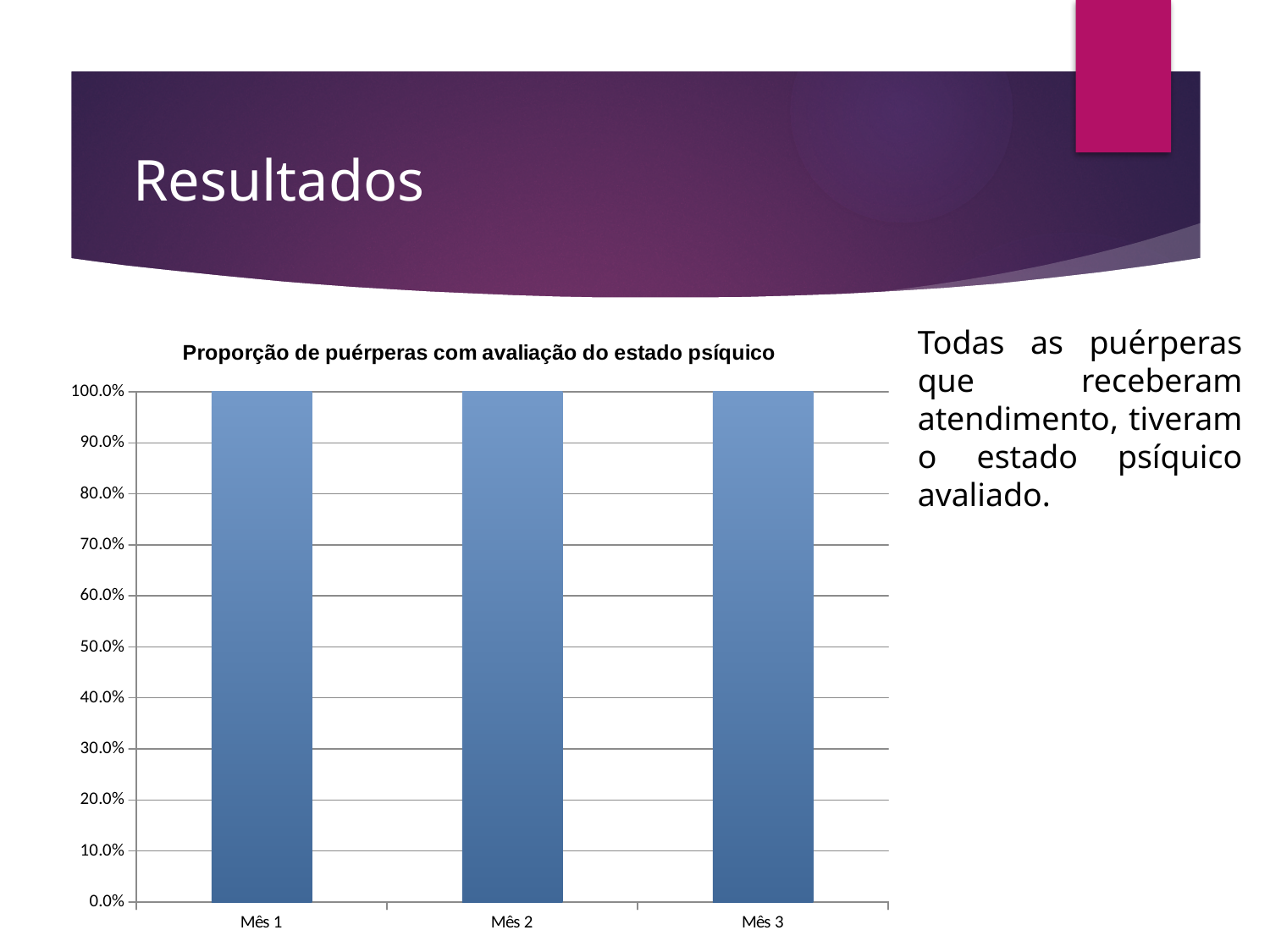
What is the value for Mês 2? 100.0% Is the value for Mês 2 greater or less than 50.0%? greater What is the difference between the values for Mês 1 and Mês 3? 0.0% What is the title of the chart? Proporção de puérperas com avaliação do estado psíquico What kind of chart is shown on the slide? bar chart How many categories are shown on the x axis of the chart? 3 Is the value for Mês 3 greater or less than 90.0%? greater What is the value for Mês 3? 100.0% What is the highest value shown on the y axis of the chart? 100.0% What is the value for Mês 1? 100.0% Do the values rise, fall or stay the same from Mês 1 to Mês 3? stay the same